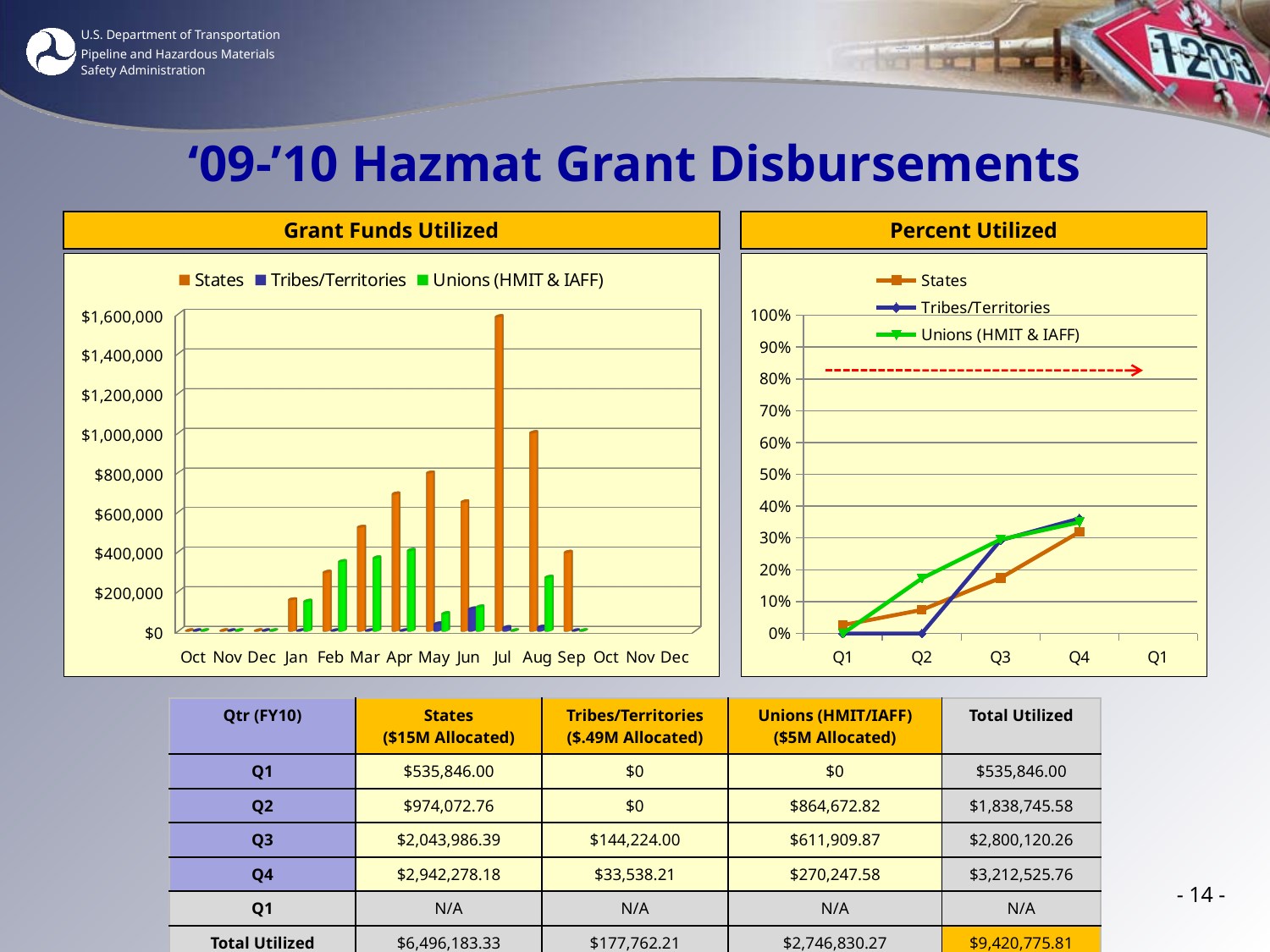
In the 'Grant Funds Utilized' chart, is the Unions (HMIT & IAFF) value for Feb greater or less than $200,000? greater What kind of chart is the 'Percent Utilized' chart? line chart How many month categories are shown on the x axis of the 'Grant Funds Utilized' chart? 15 In the 'Percent Utilized' chart, which is larger at Q2: States or Unions (HMIT & IAFF)? Unions (HMIT & IAFF) In the 'Grant Funds Utilized' chart, is the States value for Jul greater or less than $1,400,000? greater In the 'Percent Utilized' chart, does the States line rise or fall from Q1 to Q4? rise How many series does the legend of the 'Grant Funds Utilized' chart list? 3 In the 'Percent Utilized' chart, is the Unions (HMIT & IAFF) value for Q3 greater or less than 20%? greater In the 'Grant Funds Utilized' chart, which month has the highest States bar? Jul What kind of chart is the 'Grant Funds Utilized' chart? bar chart